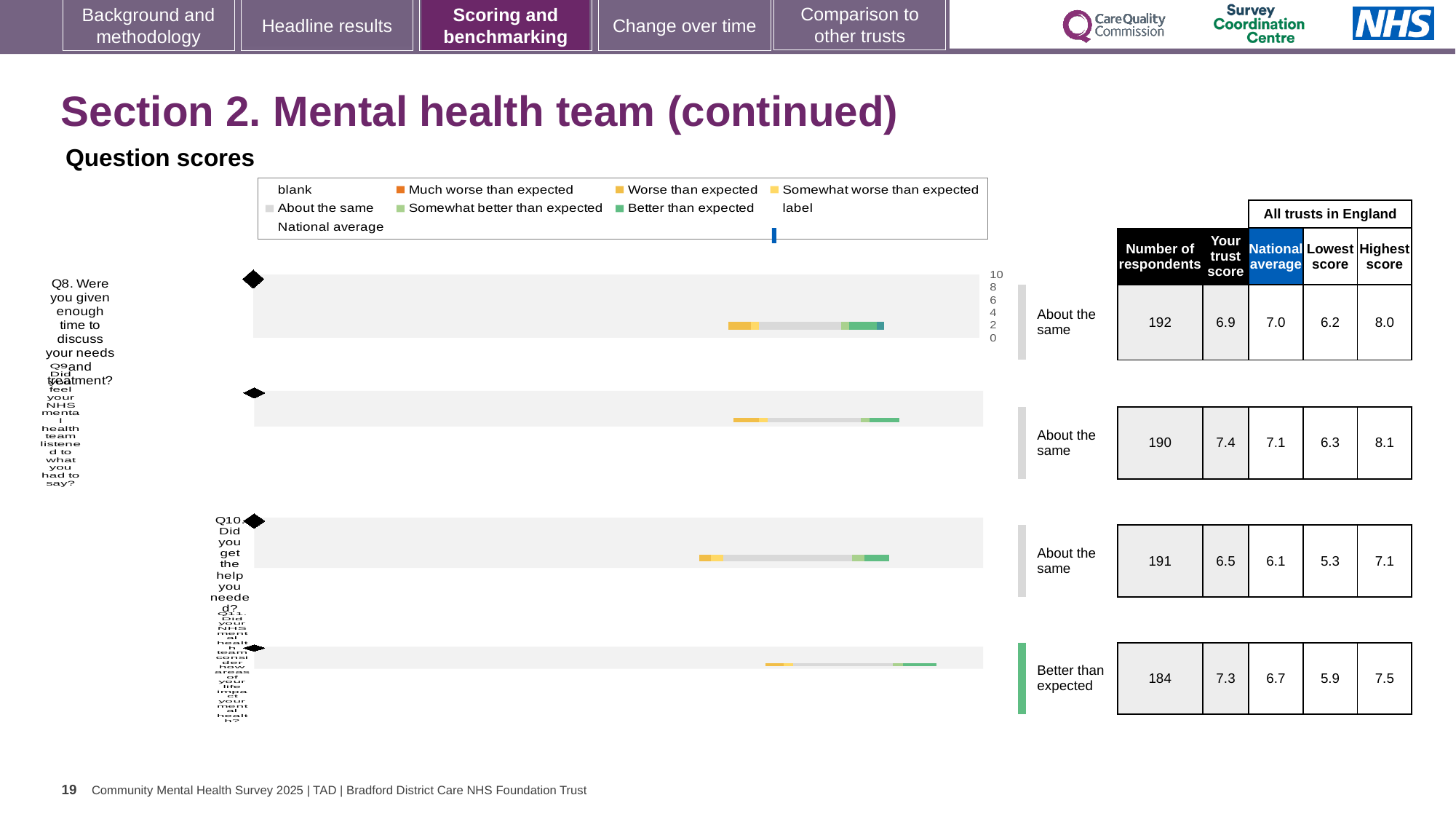
What kind of chart is used for the question scores on this slide? bar chart How many question-score charts (Q8 to Q11) are shown on the slide? 4 In the legend of the question-score charts, what colour represents 'Better than expected'? green Which question's chart is labelled 'Better than expected' rather than 'About the same'? Q11 In the legend of the question-score charts, what colour represents 'Much worse than expected'? orange For the Q10 chart, what is the difference between the trust score (6.5) and the national average (6.1)? 0.4 For the Q9 chart, how many respondents are shown in the table beside it? 190 For the Q9 chart, is the trust score (7.4) or the national average (7.1) larger? trust score (7.4) For the Q8 chart, what is the 'Your trust score' shown in the table beside it? 6.9 For the Q11 chart, what is the highest score across all trusts in England shown in the table beside it? 7.5 For the Q10 chart, what is the lowest score across all trusts in England shown in the table beside it? 5.3 For the Q8 chart, what is the national average shown in the table beside it? 7.0